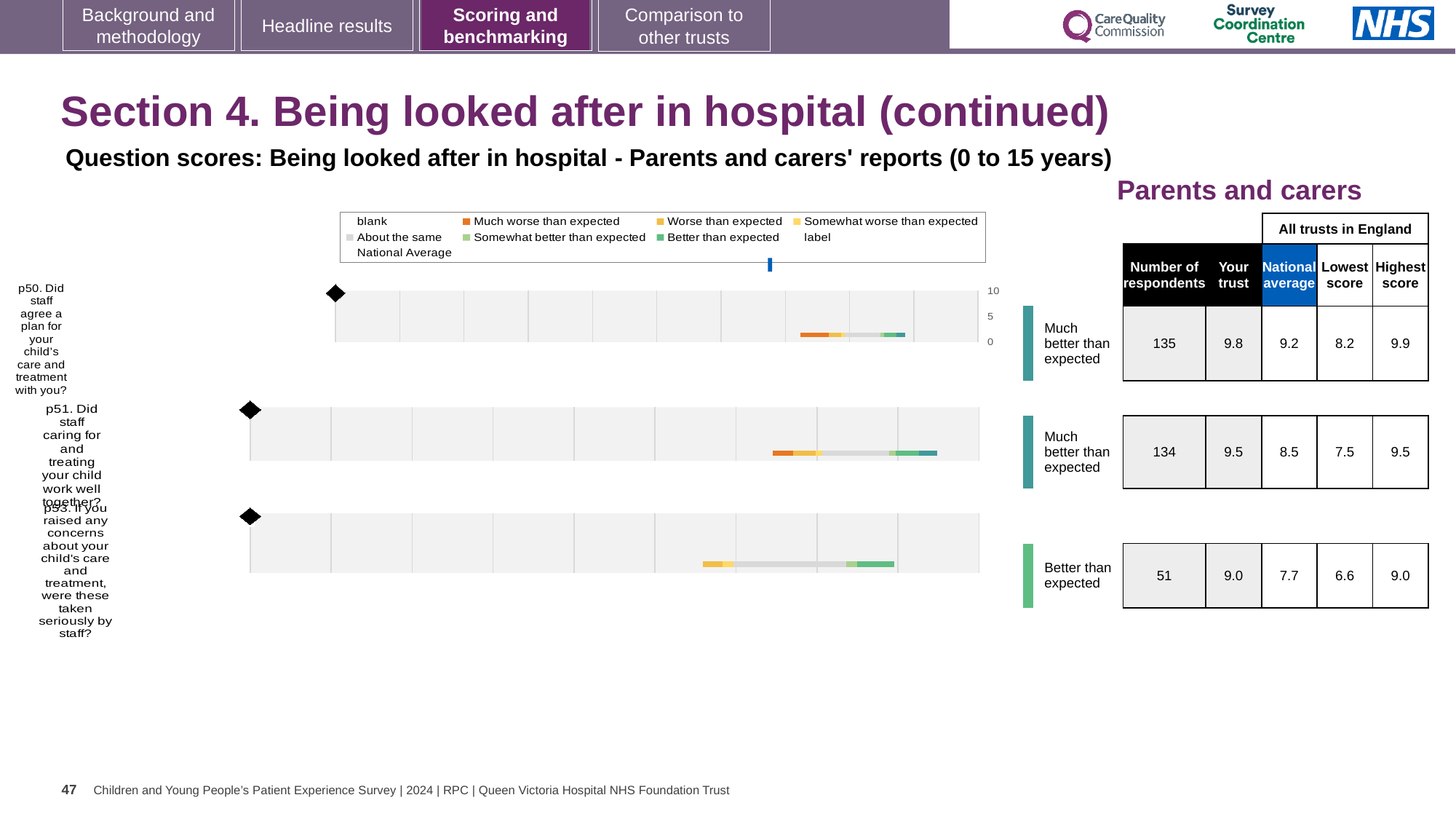
By how much does the 'Your trust' score for p50 exceed the national average for p50? 0.6 What is the national average score for p51 (Did staff caring for and treating your child work well together?)? 8.5 Which of the three questions has the fewest respondents? p53 (51) What is the 'Your trust' score for p50 (Did staff agree a plan for your child's care and treatment with you?)? 9.8 What is the highest score among all trusts in England for p50? 9.9 What is the lowest score among all trusts in England for p53? 6.6 How many respondents answered p53 (If you raised any concerns about your child's care and treatment, were these taken seriously by staff?)? 51 What benchmark category is shown for p53? Better than expected Which of the three questions has the highest 'Your trust' score? p50 (9.8) For p51, which is larger: the 'Your trust' score or the national average? Your trust (9.5) How many questions are charted on this slide? 3 What type of chart is used to show the question scores? Bar chart